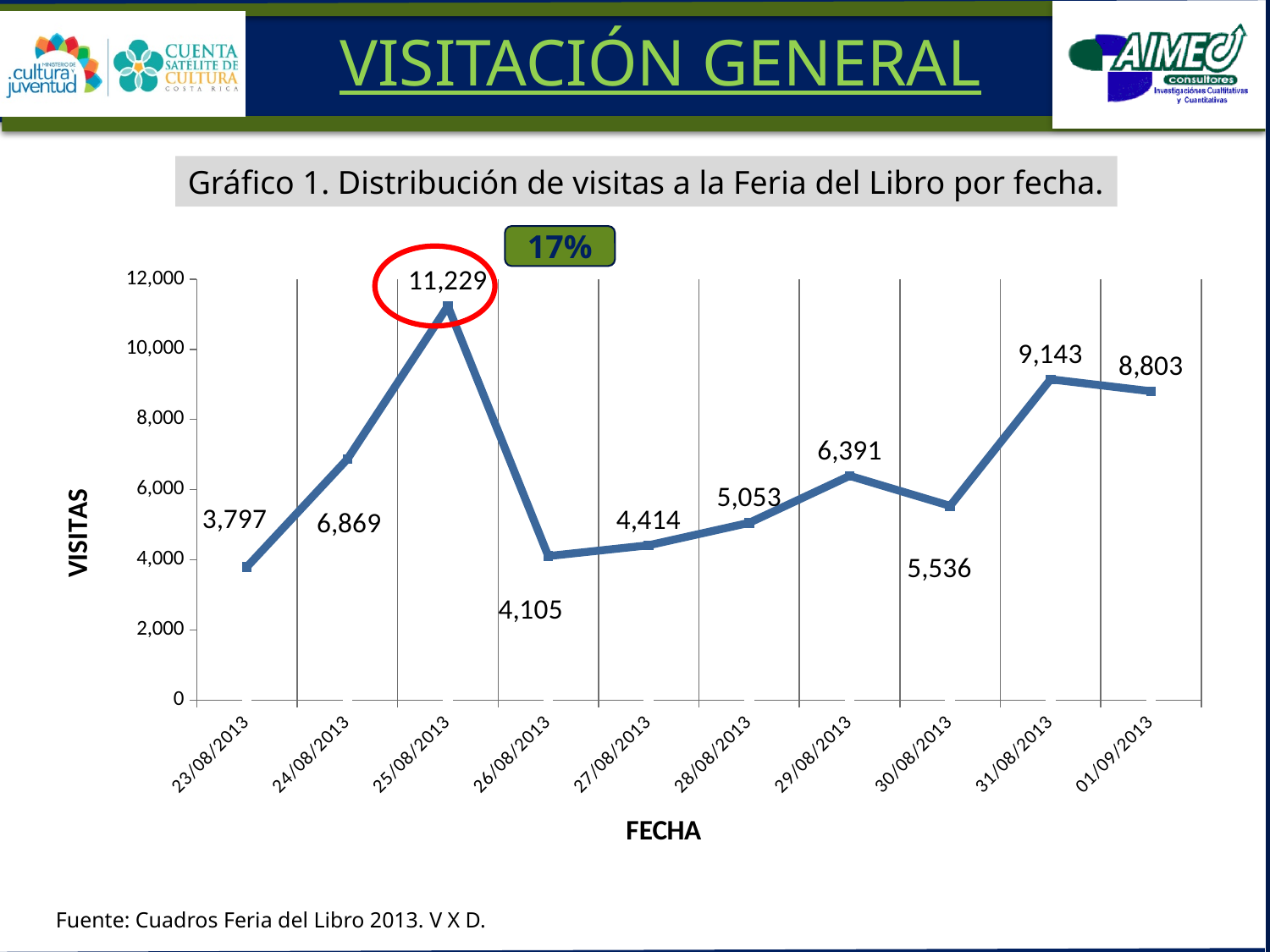
What type of chart is shown on the slide? Line chart How many dates are plotted on the x axis? 10 Which date had the lowest number of visits? 23/08/2013 How many visits were recorded on 01/09/2013? 8,803 What is the difference in visits between 31/08/2013 and 01/09/2013? 340 What percentage is shown in the green box above the peak of the chart? 17% Which date had more visits, 28/08/2013 or 30/08/2013? 30/08/2013 How many visits were recorded on 25/08/2013? 11,229 Which date had the highest number of visits? 25/08/2013 How many visits were recorded on 23/08/2013? 3,797 Did visits rise or fall from 25/08/2013 to 26/08/2013? Fall What is the title of the chart? Gráfico 1. Distribución de visitas a la Feria del Libro por fecha.